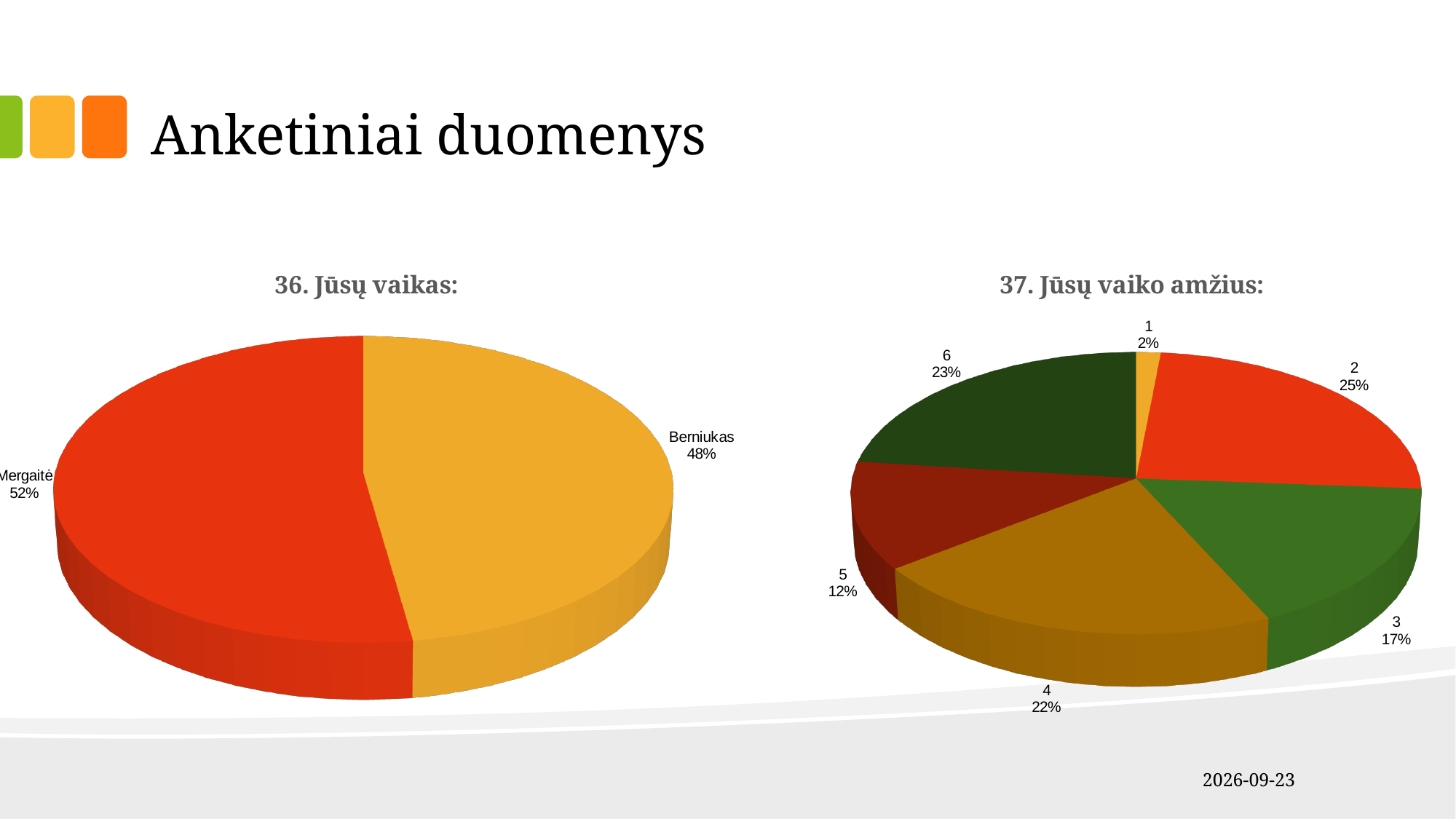
In the chart titled "37. Jūsų vaiko amžius:", which category has the largest share? 2 In the chart titled "37. Jūsų vaiko amžius:", what is the difference in percentage points between category 6 and category 3? 6 In the chart titled "37. Jūsų vaiko amžius:", which category has the smallest share? 1 What kind of chart is the chart titled "36. Jūsų vaikas:"? Pie chart In the chart titled "36. Jūsų vaikas:", how many slices does the pie have? 2 In the chart titled "36. Jūsų vaikas:", what share of the pie is Mergaitė? 52% In the chart titled "37. Jūsų vaiko amžius:", what share of the pie is category 2? 25% In the chart titled "36. Jūsų vaikas:", which category has the larger share, Mergaitė or Berniukas? Mergaitė In the chart titled "37. Jūsų vaiko amžius:", how many slices does the pie have? 6 In the chart titled "37. Jūsų vaiko amžius:", which has the larger share, category 4 or category 3? 4 In the chart titled "37. Jūsų vaiko amžius:", what share of the pie is category 5? 12%